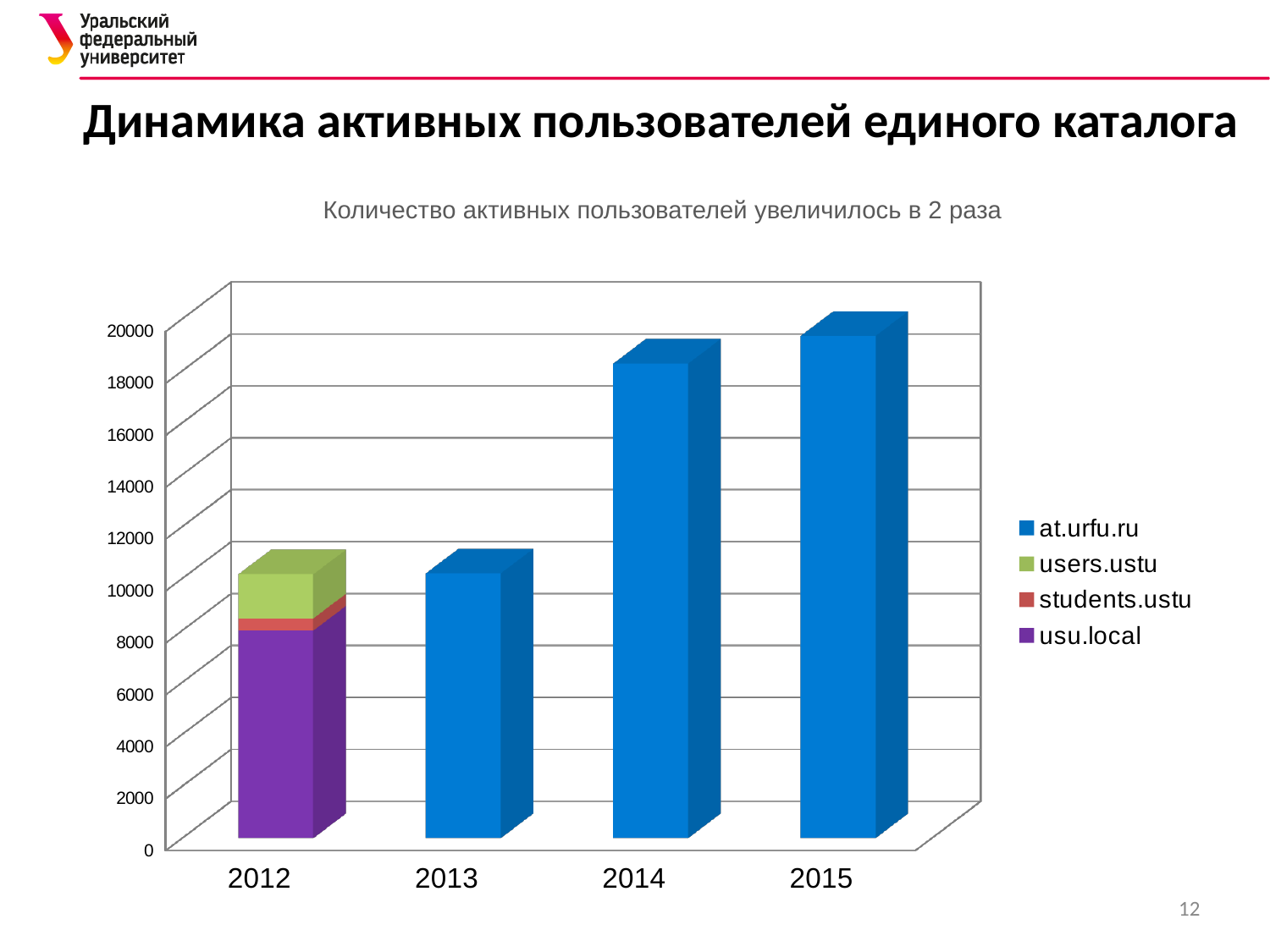
How many years are shown on the x axis of the chart? 4 Is the value for at.urfu.ru in 2014 greater or less than 16000? greater Is the value for at.urfu.ru in 2015 greater or less than 18000? greater Which series in the legend is shown in purple? usu.local Which year has the tallest bar in the chart? 2015 What kind of chart is shown on the slide? bar chart Is the value for usu.local in 2012 greater or less than 10000? less Which year has the taller bar, 2013 or 2014? 2014 Do the bar heights rise or fall from 2013 to 2015? rise What is the title shown above the chart? Количество активных пользователей увеличилось в 2 раза How many series does the chart legend list? 4